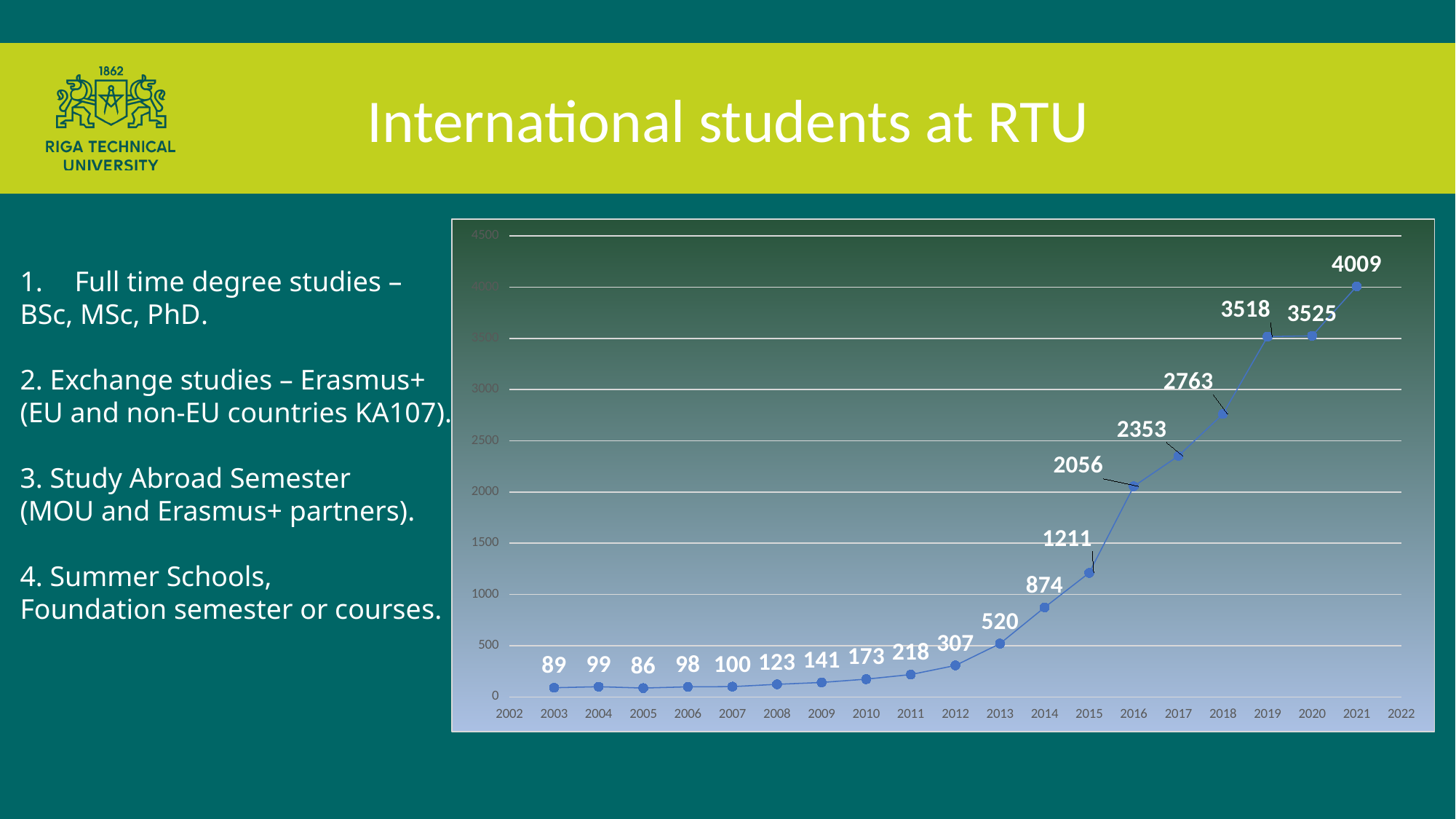
What is the value plotted for 2013? 520 Which year has the highest value? 2021 Do the values generally rise or fall from 2003 to 2021? rise Which is larger, the value for 2004 or the value for 2006? 2004 Is the value for 2017 greater or less than 2000? greater What is the value plotted for 2016? 2056 What is the difference between the values for 2019 and 2018? 755 Which year has the lowest value? 2005 What kind of chart is shown on the slide? line chart What is the value plotted for 2007? 100 How many data points are plotted on the line? 19 What is the value plotted for 2021? 4009